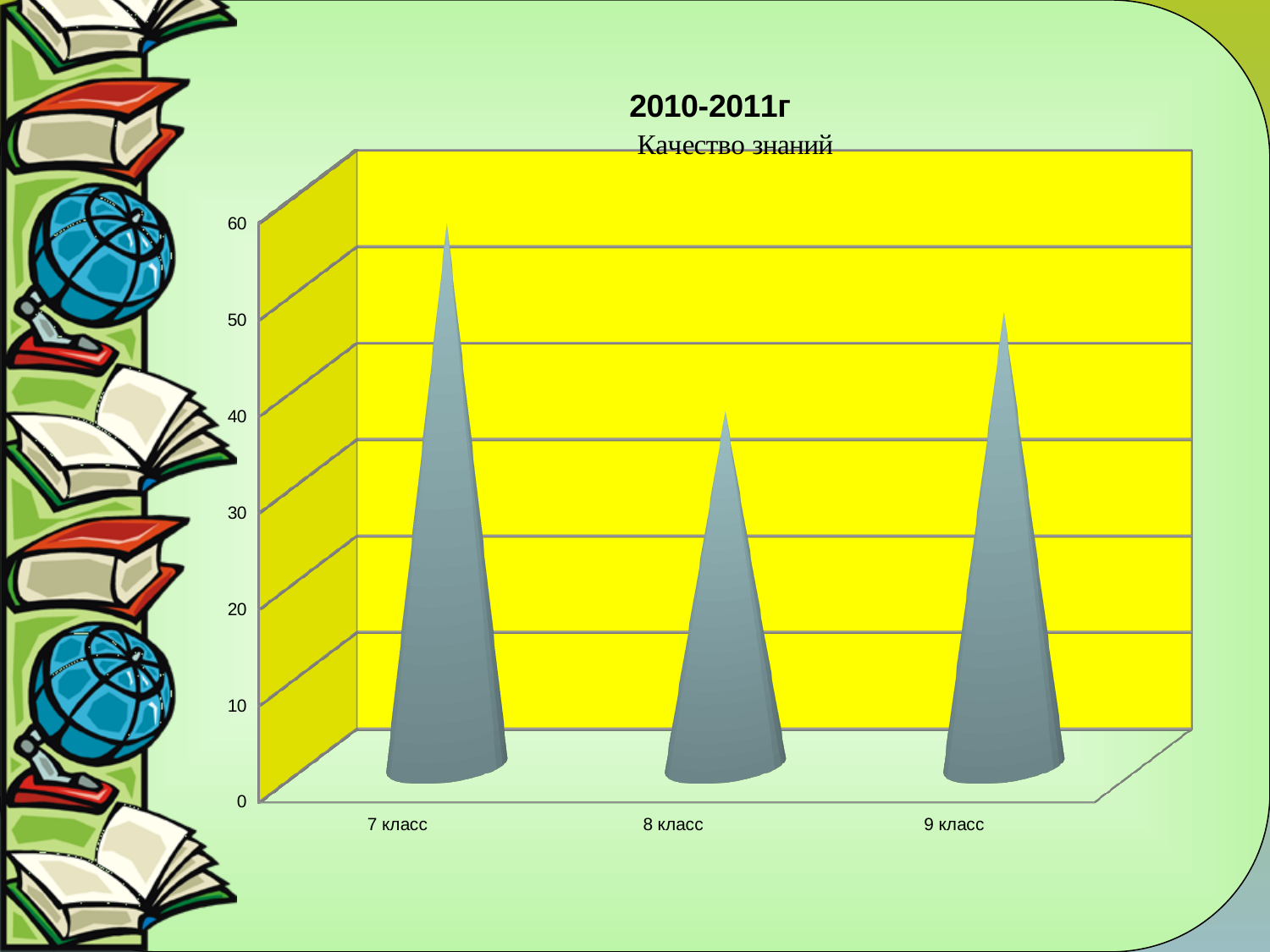
Which is larger, the value for 7 класс or the value for 8 класс? 7 класс Which is larger, the value for 9 класс or the value for 8 класс? 9 класс What school year is given in the chart title? 2010-2011г Is the value for 8 класс greater or less than 50? less Is the value for 9 класс greater or less than 40? greater Which class has the highest value on the chart? 7 класс Which class has the lowest value on the chart? 8 класс What kind of chart is shown on the slide? bar chart Is the value for 7 класс greater or less than 50? greater What is the highest value shown on the vertical axis of the chart? 60 How many classes are shown on the chart? 3